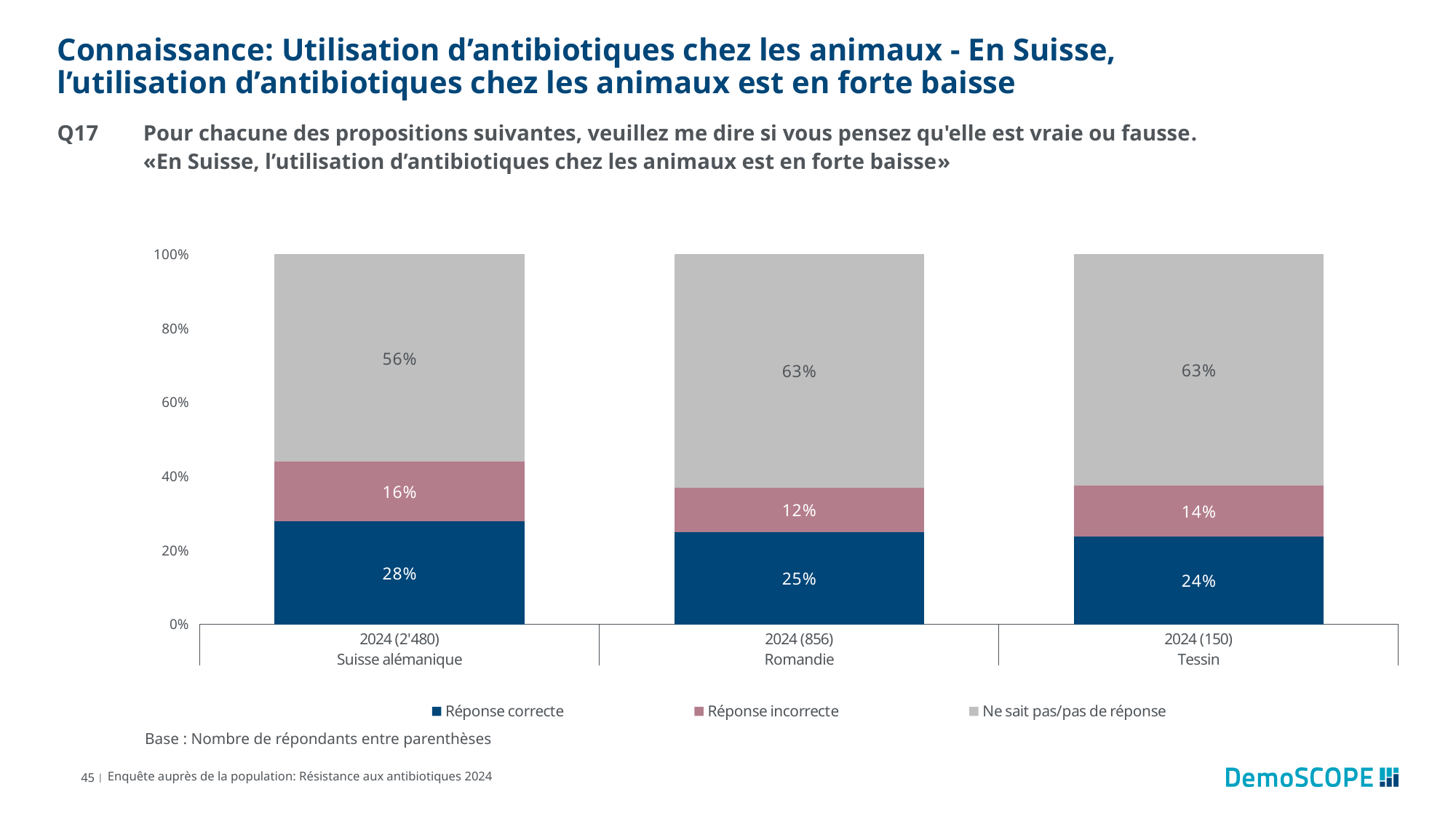
How many series does the legend list? 3 Which region has the highest share of 'Réponse correcte'? Suisse alémanique What is the number of respondents shown in parentheses for Romandie? 856 What is the value for 'Réponse incorrecte' in Tessin? 14% Which is larger: the 'Réponse correcte' value for Romandie or for Tessin? Romandie Which region has the lowest share of 'Réponse incorrecte'? Romandie Does the 'Réponse correcte' value rise or fall from Suisse alémanique to Tessin? Fall What kind of chart is shown on the slide? Stacked bar chart What is the value for 'Ne sait pas/pas de réponse' in Romandie? 63% What is the difference between the 'Réponse incorrecte' values for Suisse alémanique and Romandie? 4 percentage points What percentage of respondents in Suisse alémanique gave the correct answer (Réponse correcte)? 28% How many regions (categories) are shown on the x axis? 3